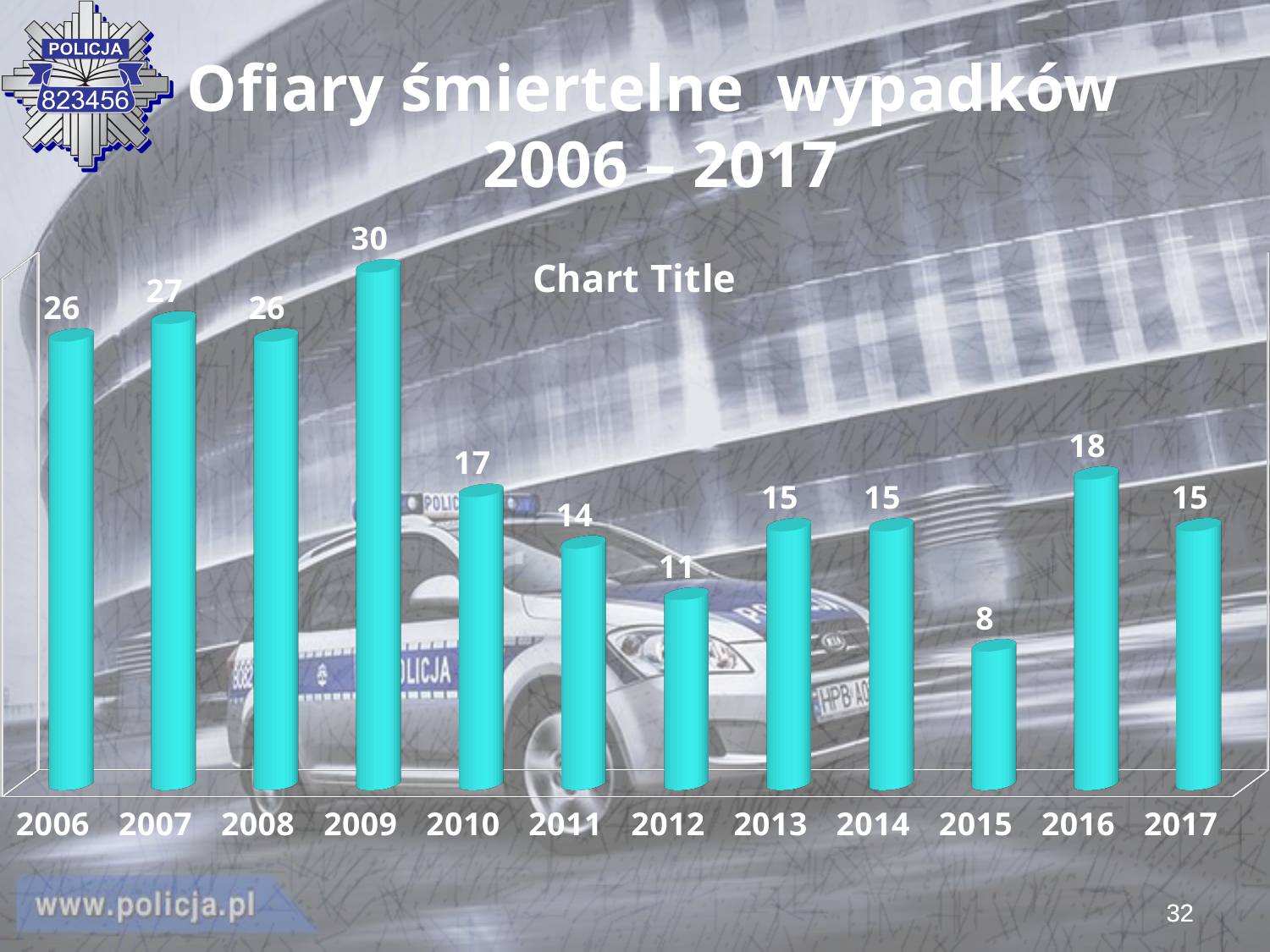
What is the value for 2016? 18 Which is larger, the value for 2011 or the value for 2016? 2016 What is the difference between the values for 2009 and 2015? 22 What is the value for 2015? 8 What is the difference between the values for 2007 and 2010? 10 What is the value for 2012? 11 What is the title shown inside the chart area? Chart Title What is the value for 2009? 30 Which year has the highest value? 2009 How many years are shown on the x axis? 12 Which year has the lowest value? 2015 What kind of chart is shown on the slide? bar chart